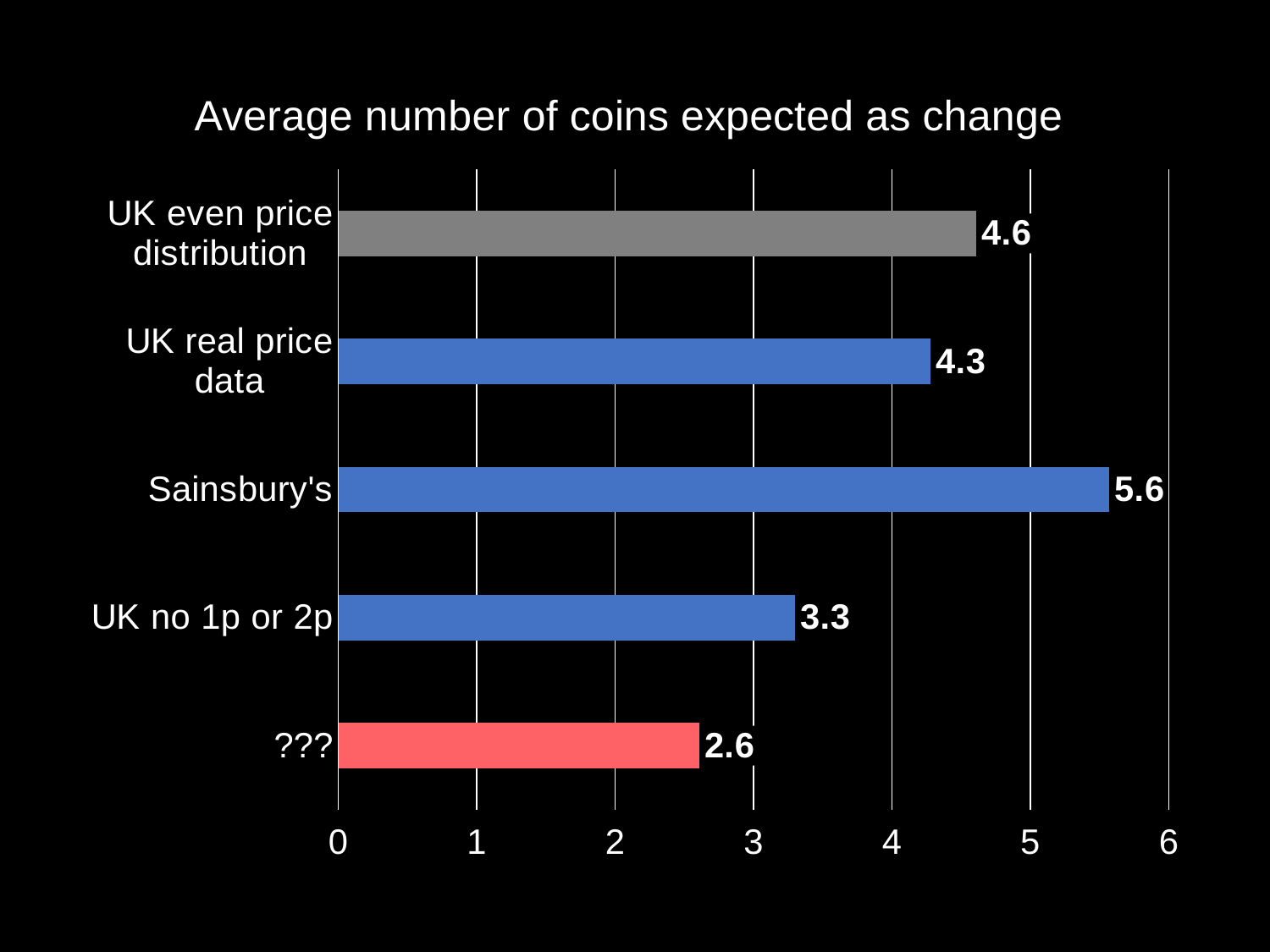
What is the value for UK even price distribution? 4.6 What is the value for Sainsbury's? 5.6 Which category has the highest average number of coins expected as change? Sainsbury's What kind of chart is shown on the slide? Bar chart What is the difference between the values for UK even price distribution and UK real price data? 0.3 How many categories are shown in the chart? 5 Which is larger, the value for UK real price data or the value for UK no 1p or 2p? UK real price data What is the value for UK no 1p or 2p? 3.3 What is the title of the chart? Average number of coins expected as change Which category has the lowest average number of coins expected as change? ??? What is the difference between the values for Sainsbury's and UK no 1p or 2p? 2.3 What is the value for UK real price data? 4.3